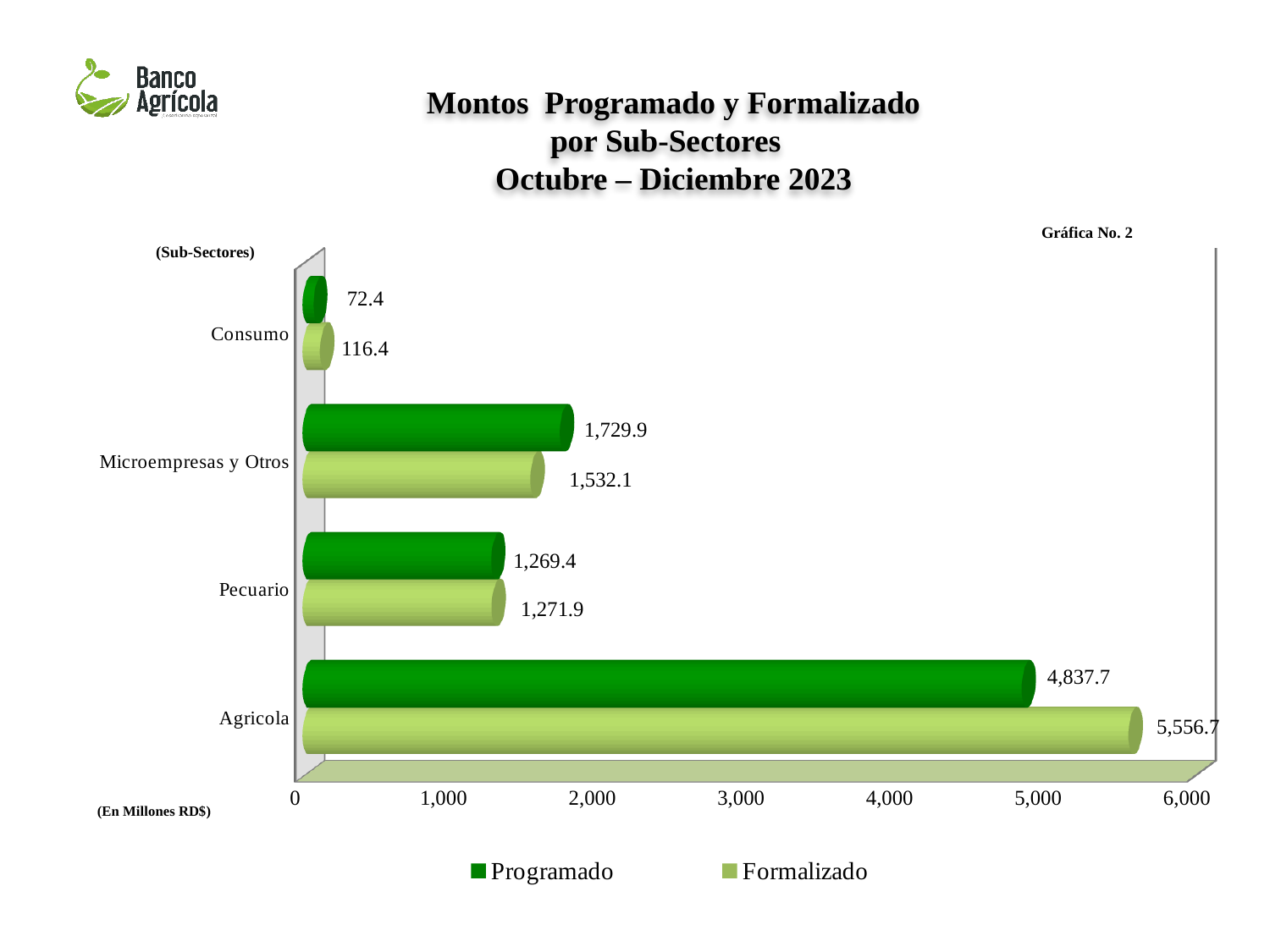
What is the Formalizado value for Consumo? 116.4 What is the difference between the Formalizado and Programado values for Agricola? 719.0 How many series does the legend list? 2 What is the Programado value for Agricola? 4,837.7 What is the difference between the Programado and Formalizado values for Microempresas y Otros? 197.8 What is the Formalizado value for Microempresas y Otros? 1,532.1 What is the Programado value for Pecuario? 1,269.4 Which sub-sector has the lowest Programado value? Consumo For Agricola, which is larger: the Programado value or the Formalizado value? Formalizado What kind of chart is shown on the slide? Bar chart Which sub-sector has the highest Formalizado value? Agricola How many sub-sectors are shown on the chart? 4